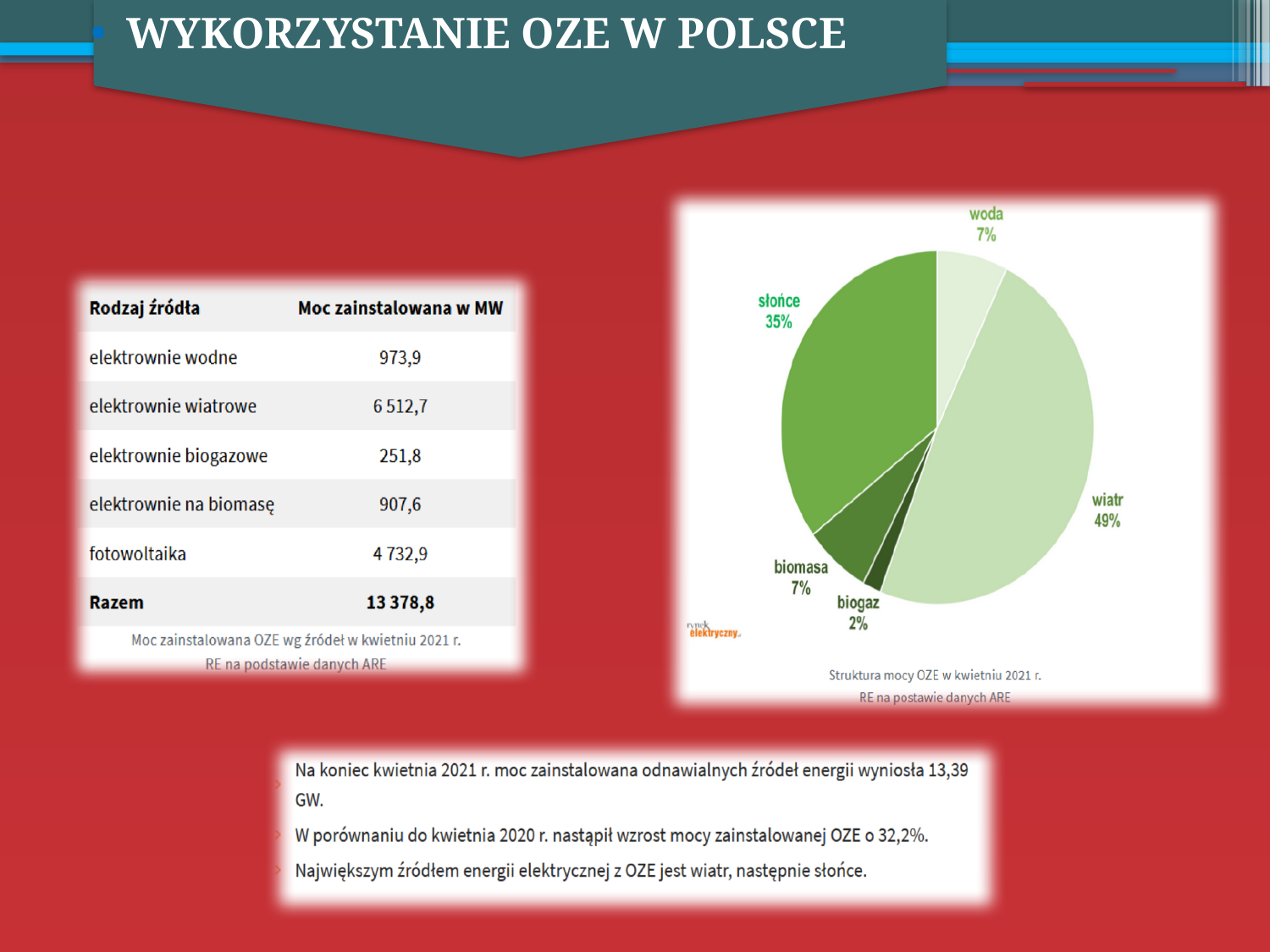
What is the combined share of the woda and biomasa slices? 14% Which slice of the pie chart is the largest? wiatr What kind of chart is shown on the slide? pie chart Which slice of the pie chart is the smallest? biogaz What is the caption under the pie chart? Struktura mocy OZE w kwietniu 2021 r. What is the difference in percentage points between the wiatr and słońce slices? 14 What share of the pie chart does wiatr have? 49% What share of the pie chart does słońce have? 35% Which slice is larger in the pie chart, biomasa or biogaz? biomasa What share of the pie chart does woda have? 7% How many slices does the pie chart have? 5 What share of the pie chart does biogaz have? 2%